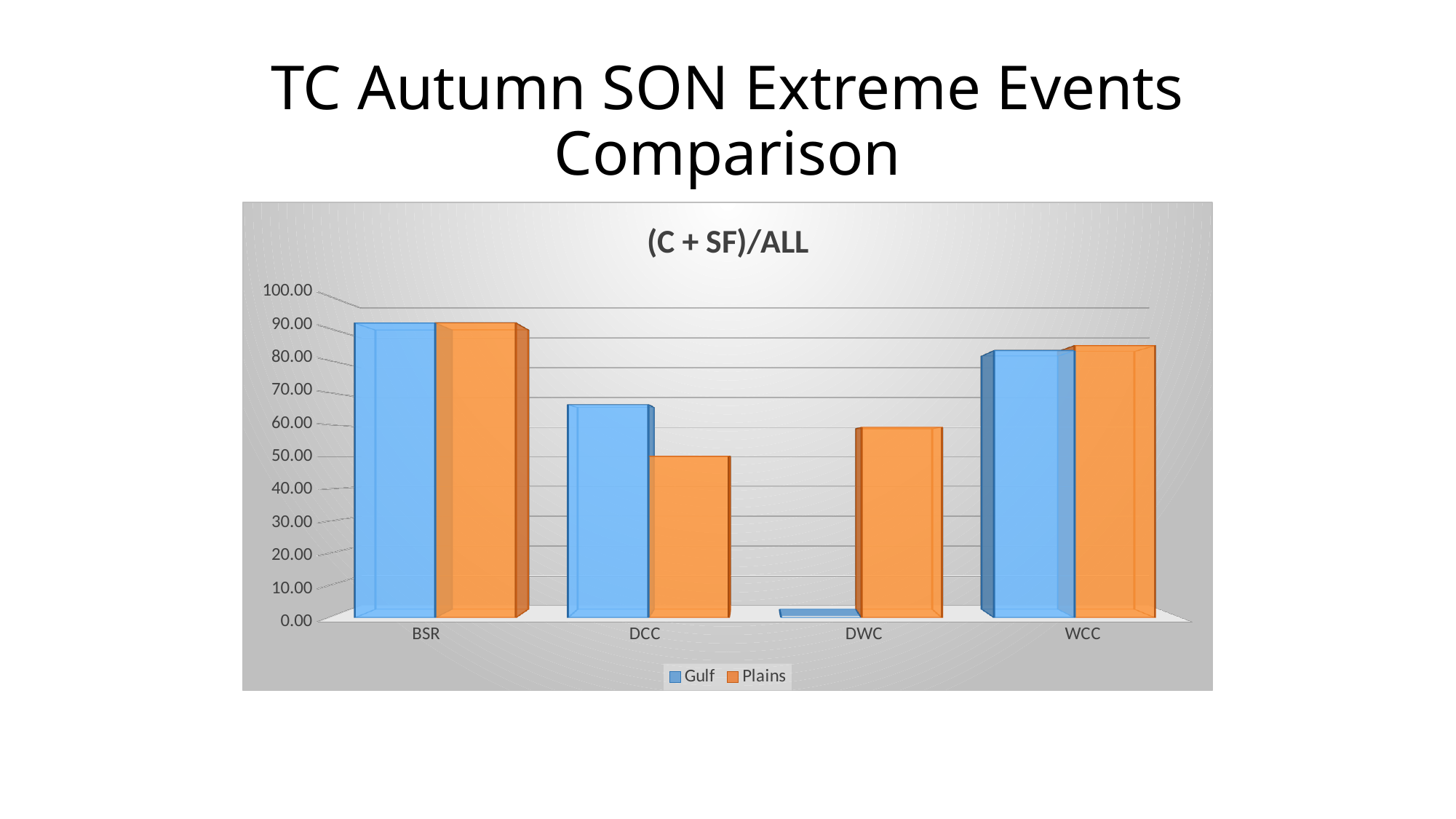
Which series is shown in orange in the chart? Plains Which category has the highest Gulf value? BSR How many series does the chart's legend list? 2 For DWC, which series has the larger value, Gulf or Plains? Plains What kind of chart is shown on the slide? bar chart Is the Gulf value for DWC greater or less than 10.00? less What is the title printed above the chart's plot area? (C + SF)/ALL For DCC, which series has the larger value, Gulf or Plains? Gulf Which category has the lowest Plains value? DCC How many categories are shown on the x axis of the chart? 4 Which category has the lowest Gulf value? DWC Is the Plains value for DCC greater or less than 70.00? less